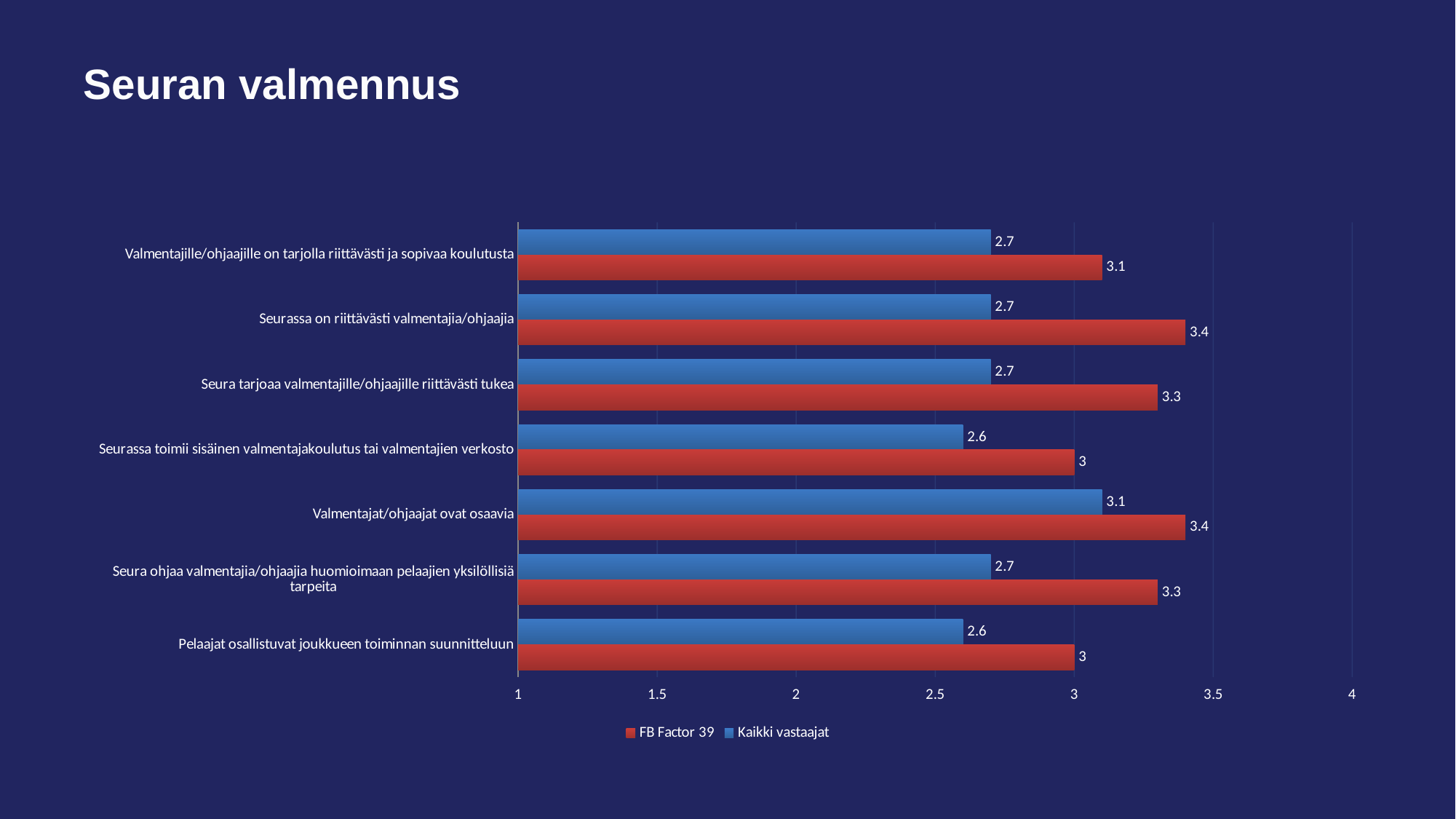
Which category has the highest Kaikki vastaajat value? Valmentajat/ohjaajat ovat osaavia For "Seura tarjoaa valmentajille/ohjaajille riittävästi tukea", which series has the larger value, FB Factor 39 or Kaikki vastaajat? FB Factor 39 What is the Kaikki vastaajat value for "Valmentajat/ohjaajat ovat osaavia"? 3.1 How many series does the legend list? 2 What is the difference between the FB Factor 39 and Kaikki vastaajat values for "Valmentajat/ohjaajat ovat osaavia"? 0.3 What is the FB Factor 39 value for "Pelaajat osallistuvat joukkueen toiminnan suunnitteluun"? 3 What is the FB Factor 39 value for "Seurassa on riittävästi valmentajia/ohjaajia"? 3.4 What is the Kaikki vastaajat value for "Seurassa toimii sisäinen valmentajakoulutus tai valmentajien verkosto"? 2.6 What kind of chart is shown on the slide? Bar chart What is the difference between the FB Factor 39 and Kaikki vastaajat values for "Seurassa on riittävästi valmentajia/ohjaajia"? 0.7 How many categories are shown on the chart? 7 What is the title of the slide? Seuran valmennus